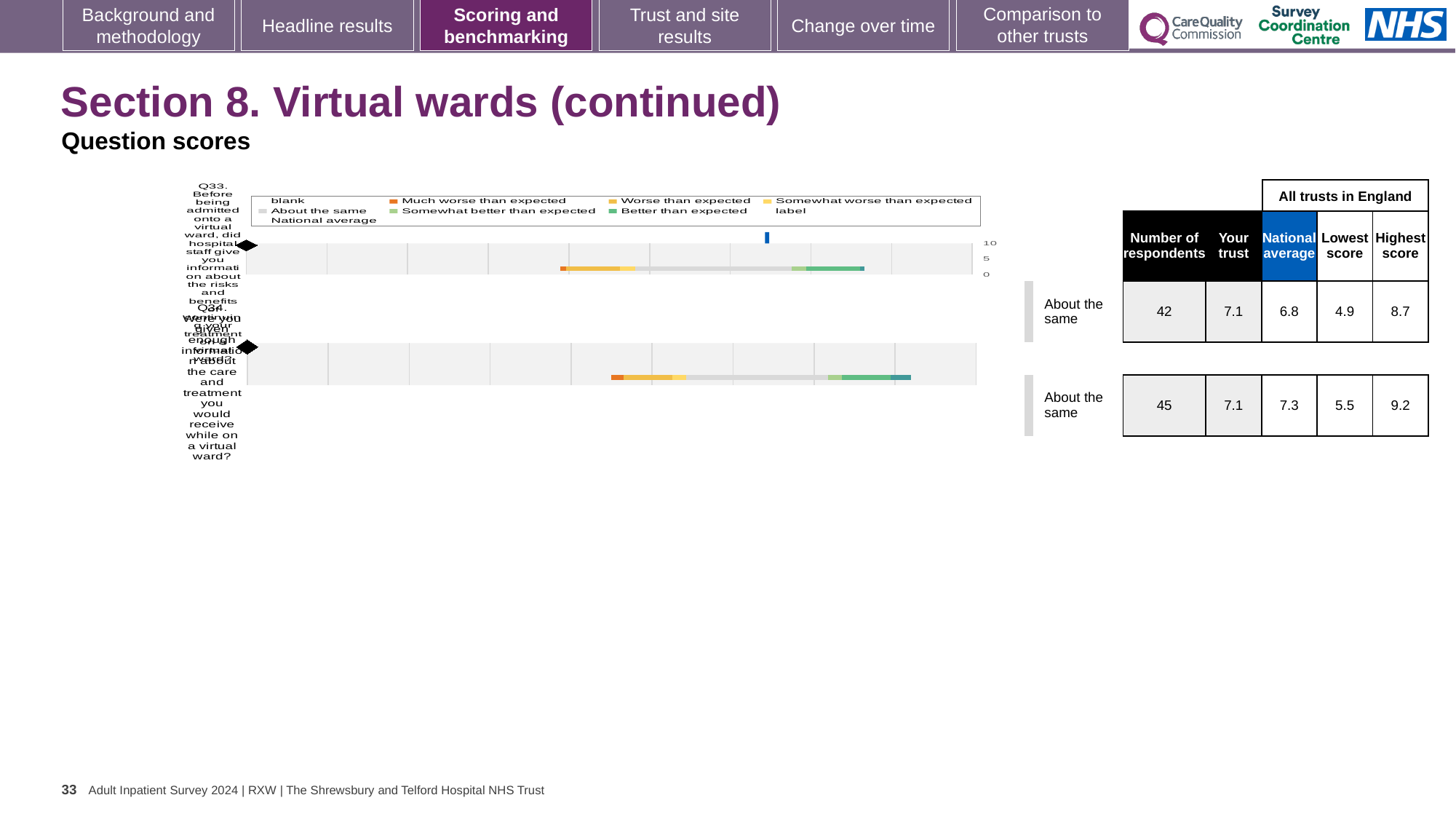
How many entries does the chart legend list? 9 For Q34, which is larger: the 'Your trust' score or the national average? National average What kind of chart is used to show the question scores on this slide? bar chart What benchmark category is shown for Q33 next to the chart? About the same For Q33, which is larger: the 'Your trust' score or the national average? Your trust How many respondents answered Q34? 45 What is the national average score for Q34? 7.3 What is the difference between the highest and lowest scores for Q33? 3.8 What is the 'Your trust' score for Q33? 7.1 What is the highest score among all trusts in England for Q34? 9.2 How many questions (categories) are plotted in the chart? 2 What is the lowest score among all trusts in England for Q33? 4.9